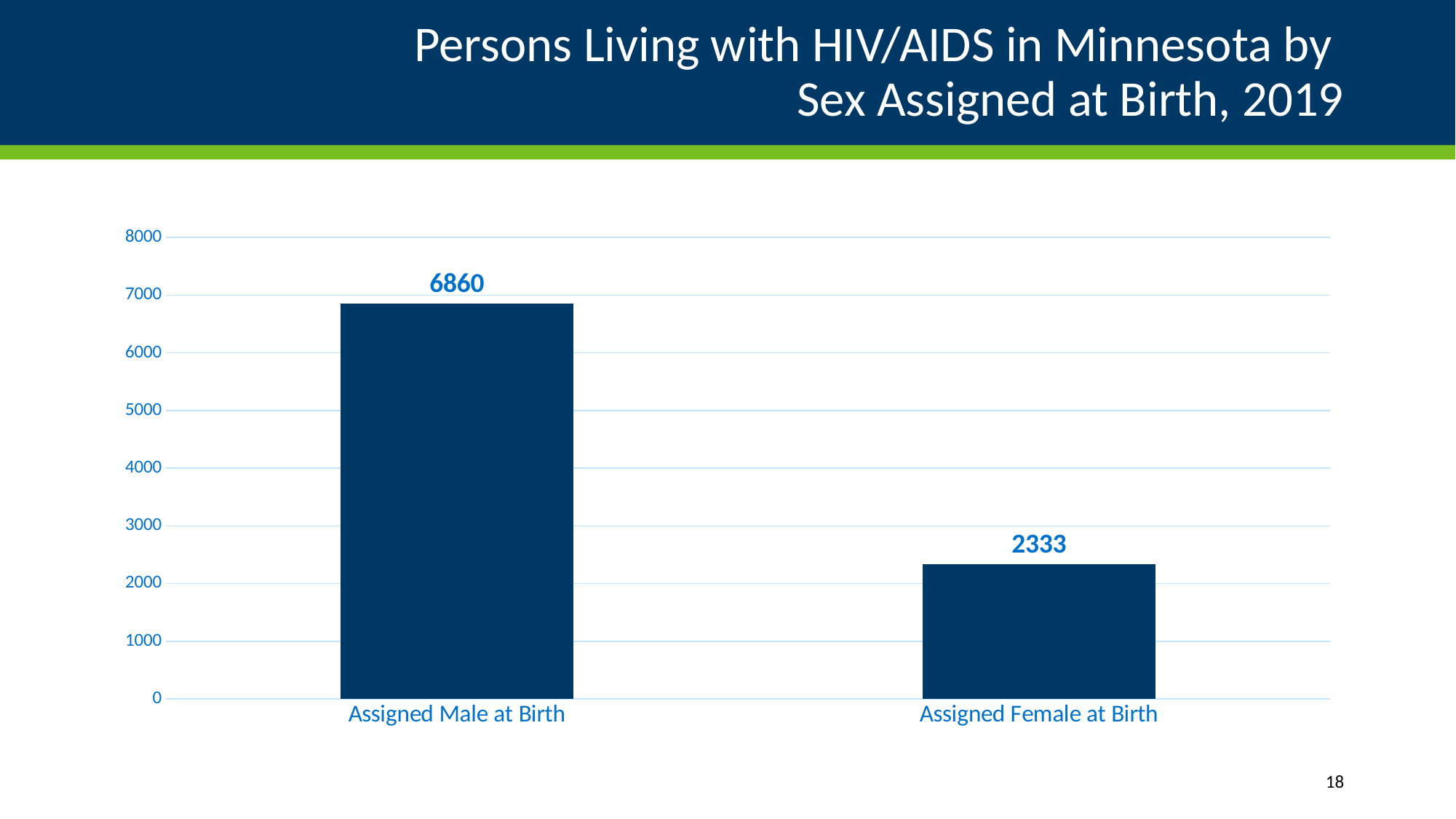
Which is larger, the value for Assigned Male at Birth or Assigned Female at Birth? Assigned Male at Birth What is the difference between the values for Assigned Male at Birth and Assigned Female at Birth? 4527 What is the title of the slide? Persons Living with HIV/AIDS in Minnesota by Sex Assigned at Birth, 2019 How many categories are shown on the chart? 2 What is the value for Assigned Male at Birth? 6860 What is the total of the two values shown on the chart? 9193 Which category has the lowest value? Assigned Female at Birth What kind of chart is shown on the slide? bar chart Is the value for Assigned Female at Birth greater or less than 3000? less Is the value for Assigned Male at Birth greater or less than 6000? greater Which category has the highest value? Assigned Male at Birth What is the value for Assigned Female at Birth? 2333